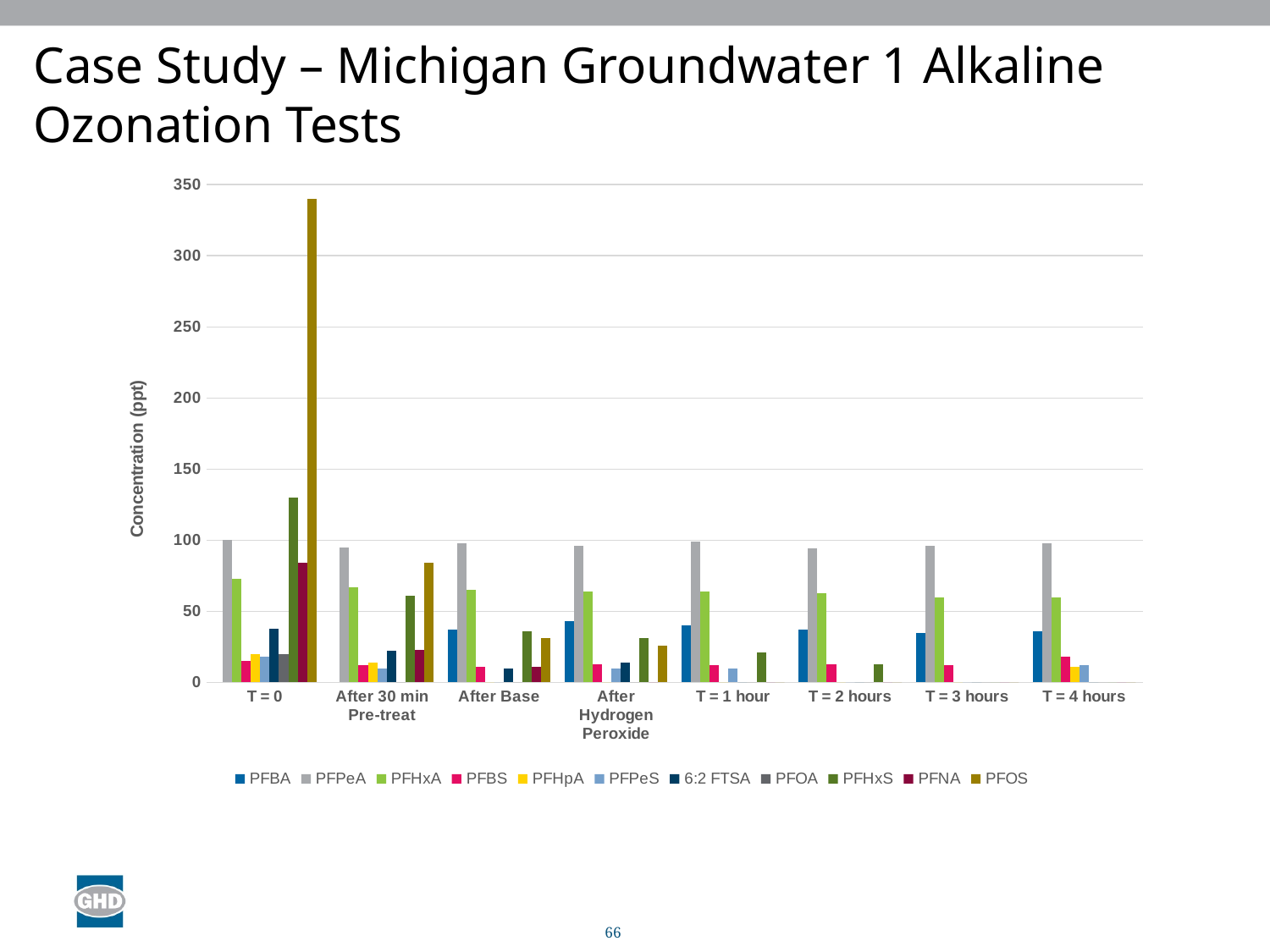
Is the value for PFHxA at T = 4 hours greater or less than 100? less Is the value for PFOS at After 30 min Pre-treat greater or less than 50? greater Is the value for PFOS at T = 0 greater or less than 300? greater At T = 0, which is larger, the value for PFOS or the value for PFHxS? PFOS Does the value for PFOS rise or fall from T = 0 to After Hydrogen Peroxide? fall How many series does the chart's legend list? 11 What is the label on the vertical axis of the chart? Concentration (ppt) What kind of chart is shown on the slide? bar chart How many categories are shown along the x axis of the chart? 8 Which series has the highest value at T = 0? PFOS